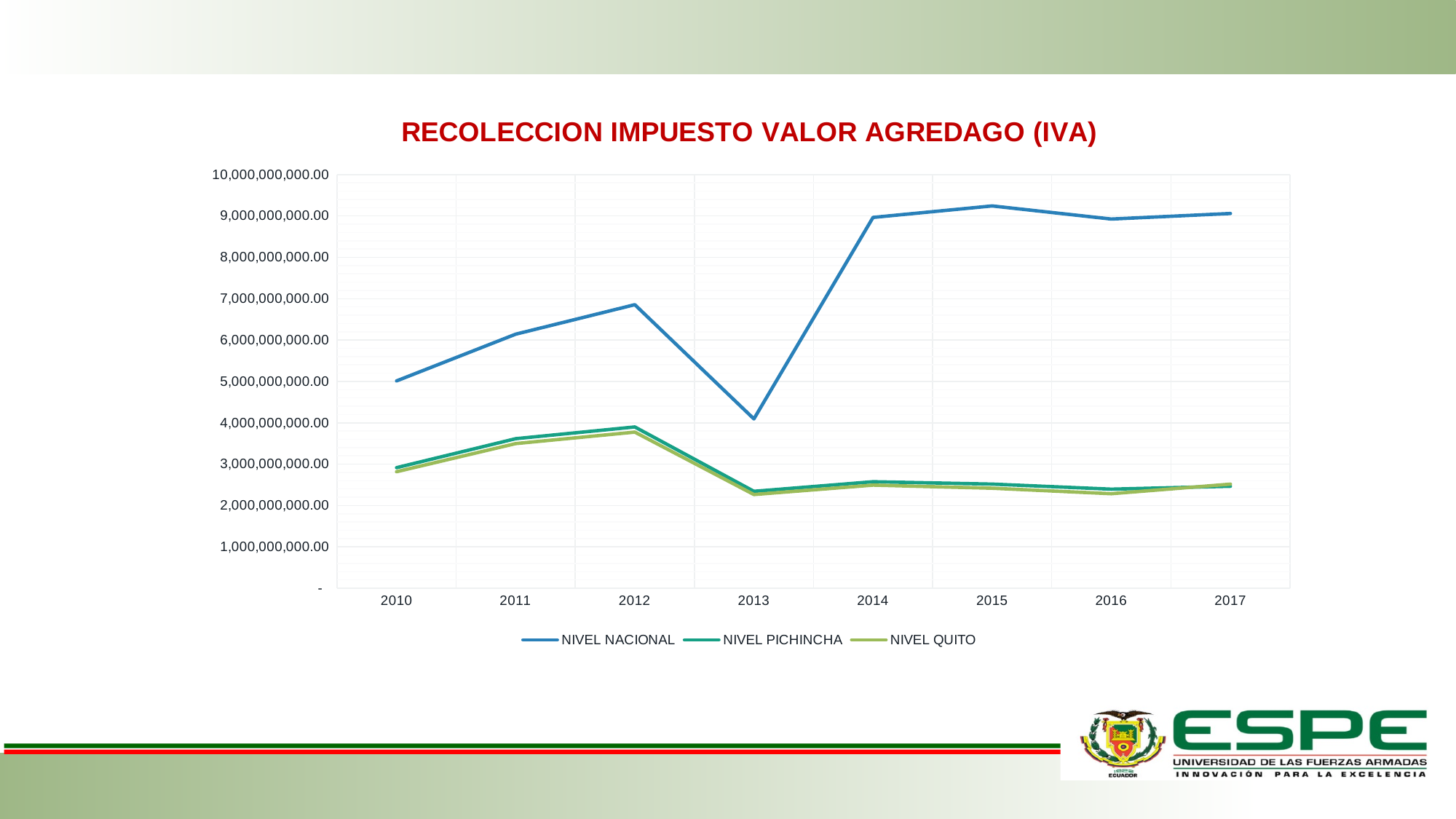
How many years are plotted along the x axis? 8 Does the NIVEL NACIONAL line rise or fall from 2012 to 2013? fall In which year is the NIVEL PICHINCHA value highest? 2012 How many series does the legend list? 3 What kind of chart is shown on the slide? line chart Which colour is used for the NIVEL NACIONAL line? blue What is the title of the chart? RECOLECCION IMPUESTO VALOR AGREDAGO (IVA) Is the NIVEL NACIONAL value for 2014 greater or less than 8,000,000,000.00? greater Is the NIVEL NACIONAL value for 2013 greater or less than 5,000,000,000.00? less Is the NIVEL PICHINCHA value for 2013 greater or less than 3,000,000,000.00? less In which year is the NIVEL NACIONAL value lowest? 2013 In which year is the NIVEL NACIONAL value highest? 2015